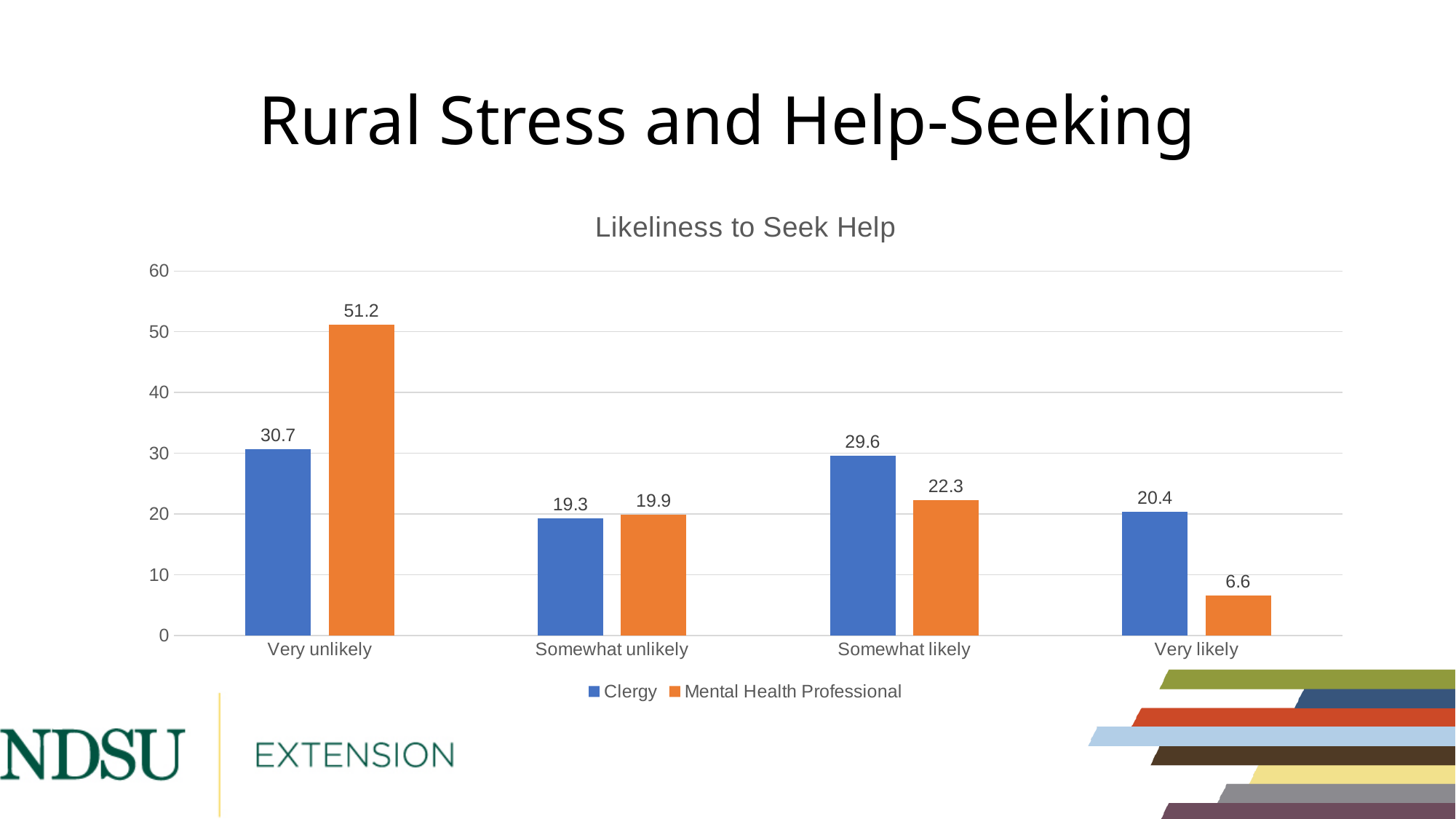
What is the title of the chart? Likeliness to Seek Help How many series does the legend list? 2 What is the Mental Health Professional value for Very unlikely? 51.2 Is the Clergy value for Somewhat unlikely greater or less than 20? less What is the Clergy value for Somewhat likely? 29.6 What is the difference between the Mental Health Professional and Clergy values for Very unlikely? 20.5 What is the Mental Health Professional value for Very likely? 6.6 Which category has the highest Clergy value? Very unlikely How many categories are shown on the x axis? 4 Which category has the lowest Mental Health Professional value? Very likely For Very likely, which series has the larger value, Clergy or Mental Health Professional? Clergy What kind of chart is shown? bar chart